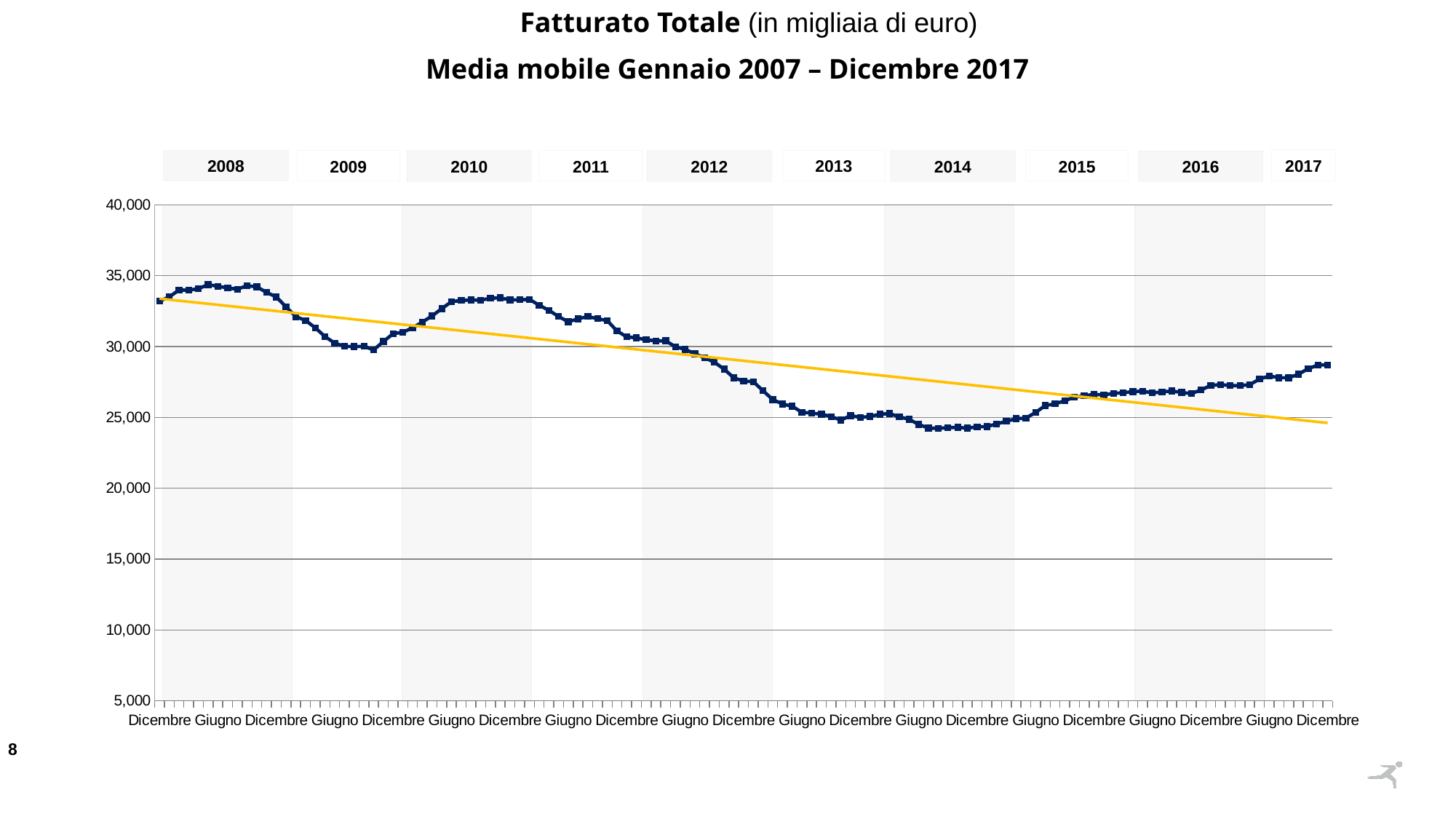
What is the title of the chart? Fatturato Totale (in migliaia di euro) Media mobile Gennaio 2007 – Dicembre 2017 Is the value of the moving average in Dicembre 2014 greater or less than 30,000? less What is the highest value shown on the vertical axis? 40,000 Does the yellow trend line rise or fall from left to right? fall Is the value of the moving average in Giugno 2013 greater or less than 30,000? less Overall, does the moving average rise or fall between Dicembre 2007 and Dicembre 2017? fall Which is larger, the moving average in Giugno 2008 or in Giugno 2014? Giugno 2008 Is the value of the moving average in Giugno 2010 greater or less than 30,000? greater What kind of chart is shown on the slide? line chart How many year labels are shown above the chart? 10